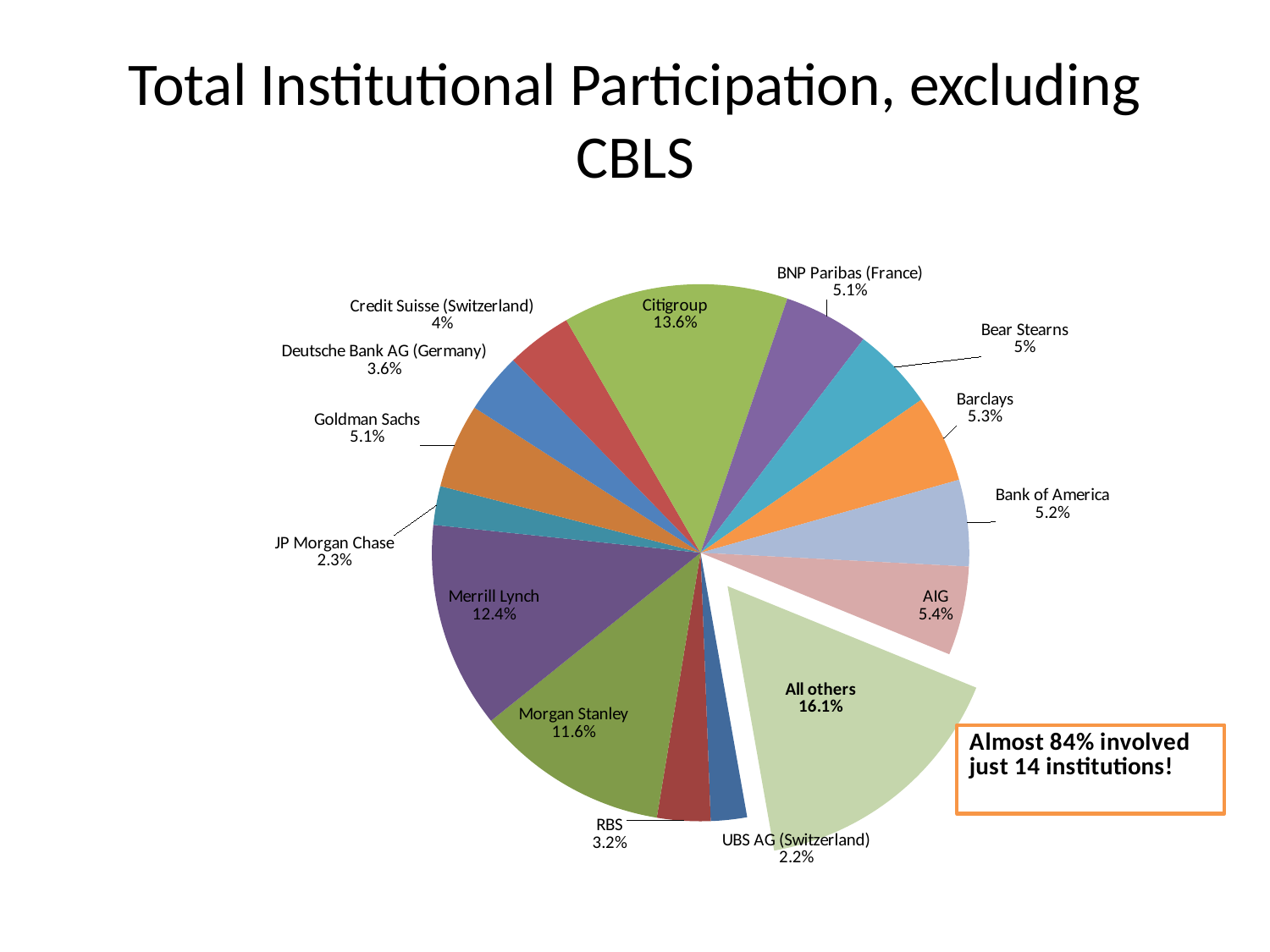
What share of the pie does Citigroup hold? 13.6% Which slice of the pie is the smallest? UBS AG (Switzerland) What is the title of the chart on the slide? Total Institutional Participation, excluding CBLS What percentage is shown for AIG? 5.4% What is the difference between the Citigroup and Merrill Lynch shares? 1.2% Which is larger, the Morgan Stanley slice or the Merrill Lynch slice? Merrill Lynch What is the value for UBS AG (Switzerland)? 2.2% What kind of chart is shown on the slide? pie chart Which slice of the pie is the largest? All others What is the difference between the All others slice and the Citigroup slice? 2.5% What is the value shown for Merrill Lynch? 12.4% How many slices does the pie chart have? 15